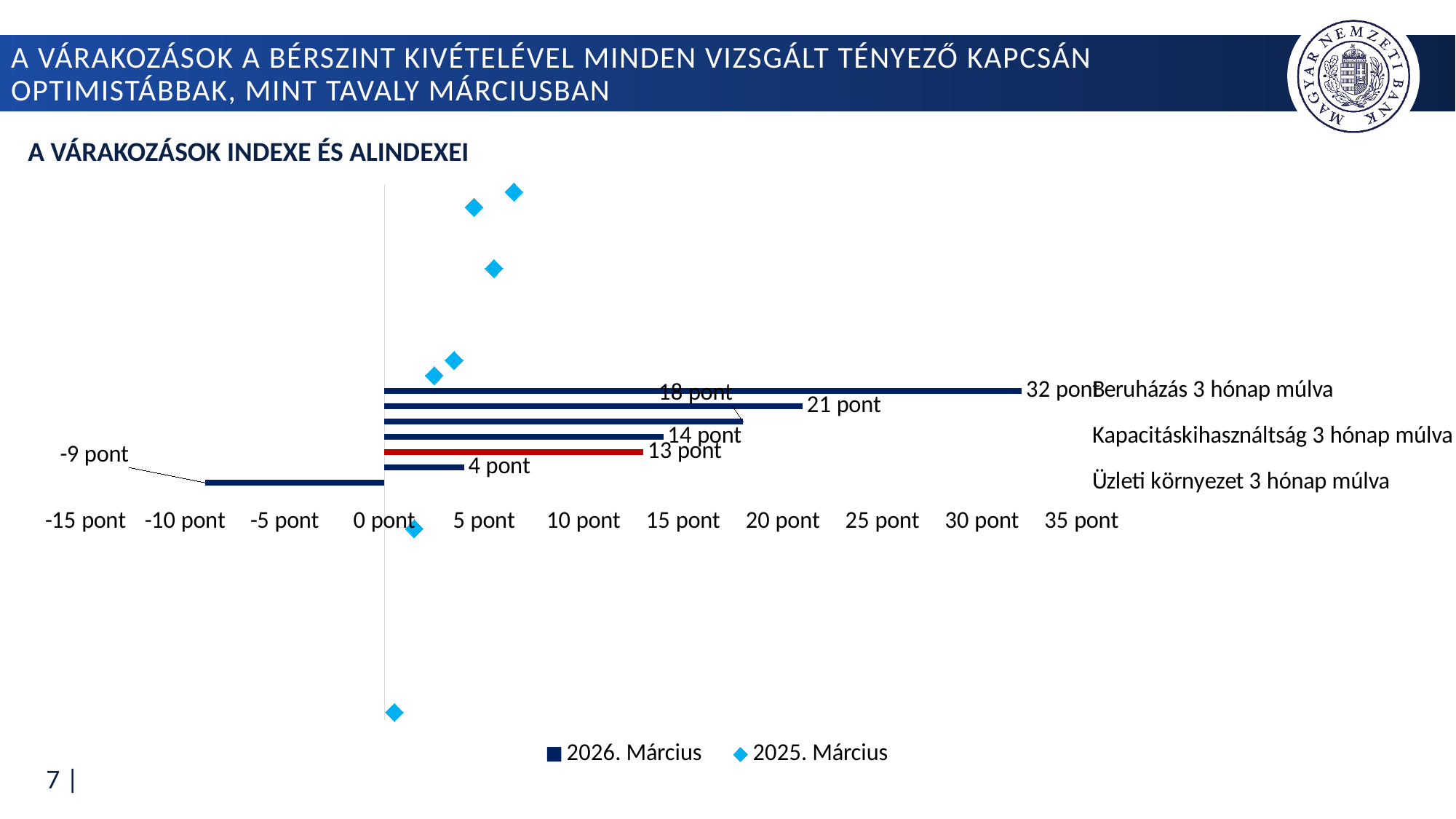
What value is labelled on the red bar? 13 pont What is the highest value labelled on a bar in the chart? 32 pont What is the difference between the longest bar (32 pont) and the second longest bar (21 pont)? 11 pont What kind of chart is shown on the slide? bar chart What are the two series named in the legend? 2026. Március and 2025. Március Which is larger, the bar labelled 21 pont or the bar labelled 18 pont? 21 pont What is the lowest value labelled on a bar in the chart? -9 pont Is the value of the longest bar greater or less than 30 pont? greater How many series does the legend list? 2 How many bars in the chart have a negative value? 1 How many bars are plotted for the 2026. Március series? 7 What is the title of the chart? A VÁRAKOZÁSOK INDEXE ÉS ALINDEXEI